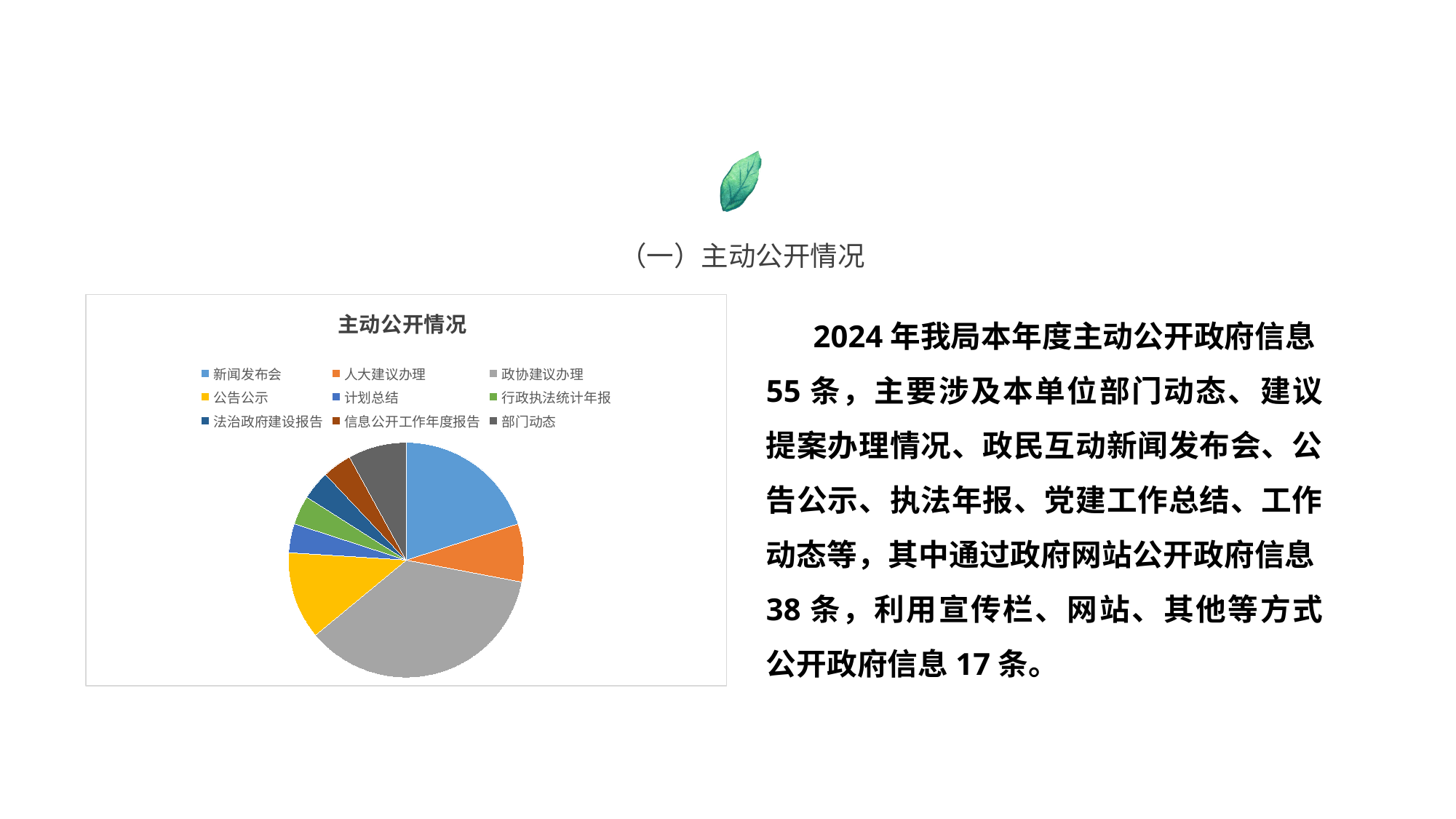
Which slice is larger, 公告公示 or 计划总结? 公告公示 Which slice is larger, 公告公示 or 部门动态? 公告公示 What kind of chart is shown on the slide? pie chart Which slice is larger, 新闻发布会 or 人大建议办理? 新闻发布会 How many categories does the legend of the pie chart list? 9 Which category has the largest slice in the pie chart? 政协建议办理 What colour is the slice for 公告公示 in the pie chart? yellow What is the title of the chart? 主动公开情况